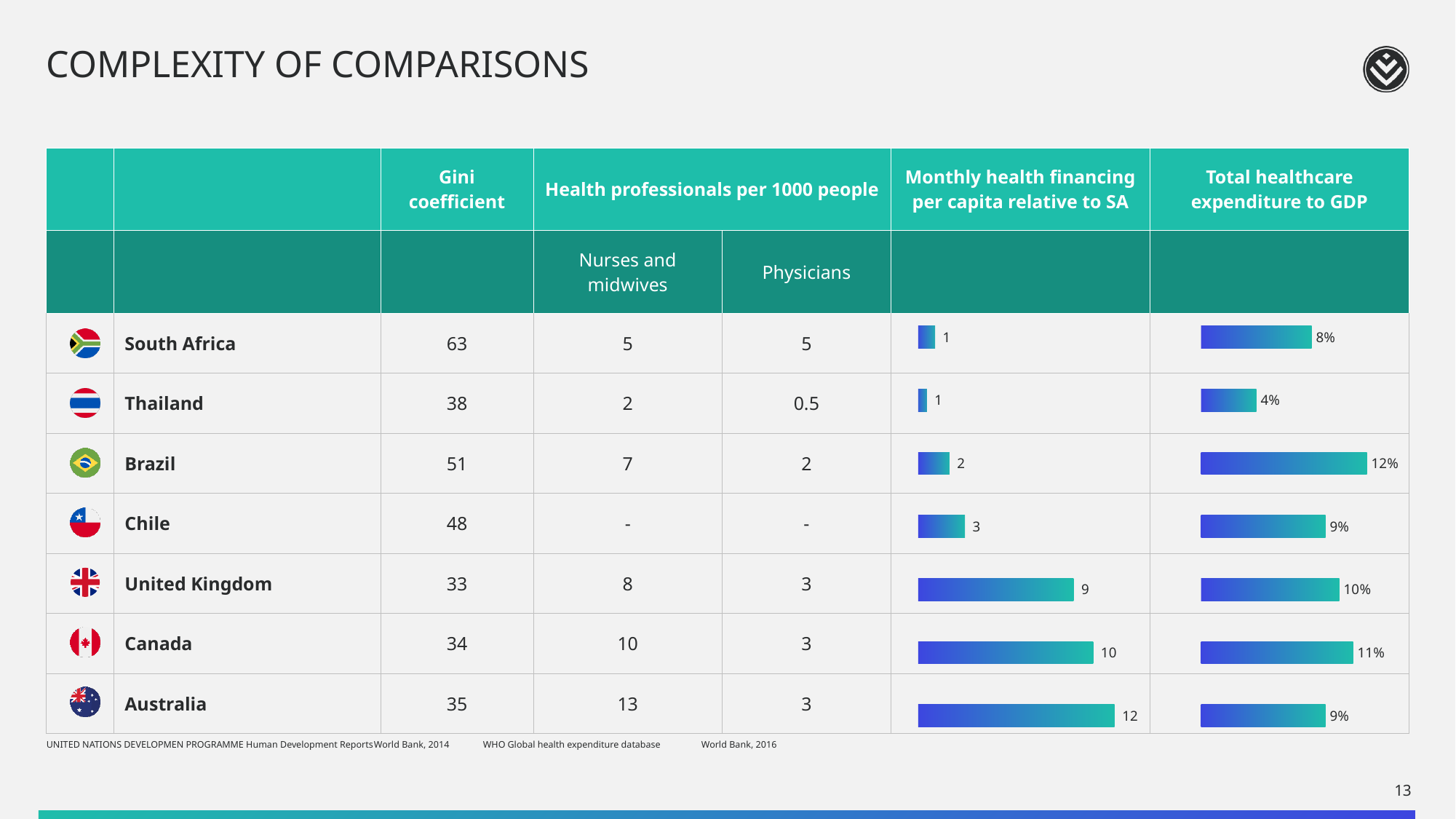
In the 'Total healthcare expenditure to GDP' chart, which is larger, the value for Thailand or the value for Chile? Chile In the 'Total healthcare expenditure to GDP' chart, what is the value for Brazil? 12% In the 'Total healthcare expenditure to GDP' chart, which country has the highest value? Brazil In the 'Monthly health financing per capita relative to SA' chart, what is the value for Australia? 12 How many countries are plotted in the 'Monthly health financing per capita relative to SA' chart? 7 In the 'Total healthcare expenditure to GDP' chart, what is the value for the United Kingdom? 10% In the 'Total healthcare expenditure to GDP' chart, what is the difference between Canada and South Africa? 3% In the 'Monthly health financing per capita relative to SA' chart, which is larger, the value for the United Kingdom or the value for Brazil? United Kingdom In the 'Monthly health financing per capita relative to SA' chart, what is the difference between Canada and Chile? 7 What kind of chart is used for 'Total healthcare expenditure to GDP'? Bar chart In the 'Total healthcare expenditure to GDP' chart, which country has the lowest value? Thailand In the 'Monthly health financing per capita relative to SA' chart, which country has the highest value? Australia